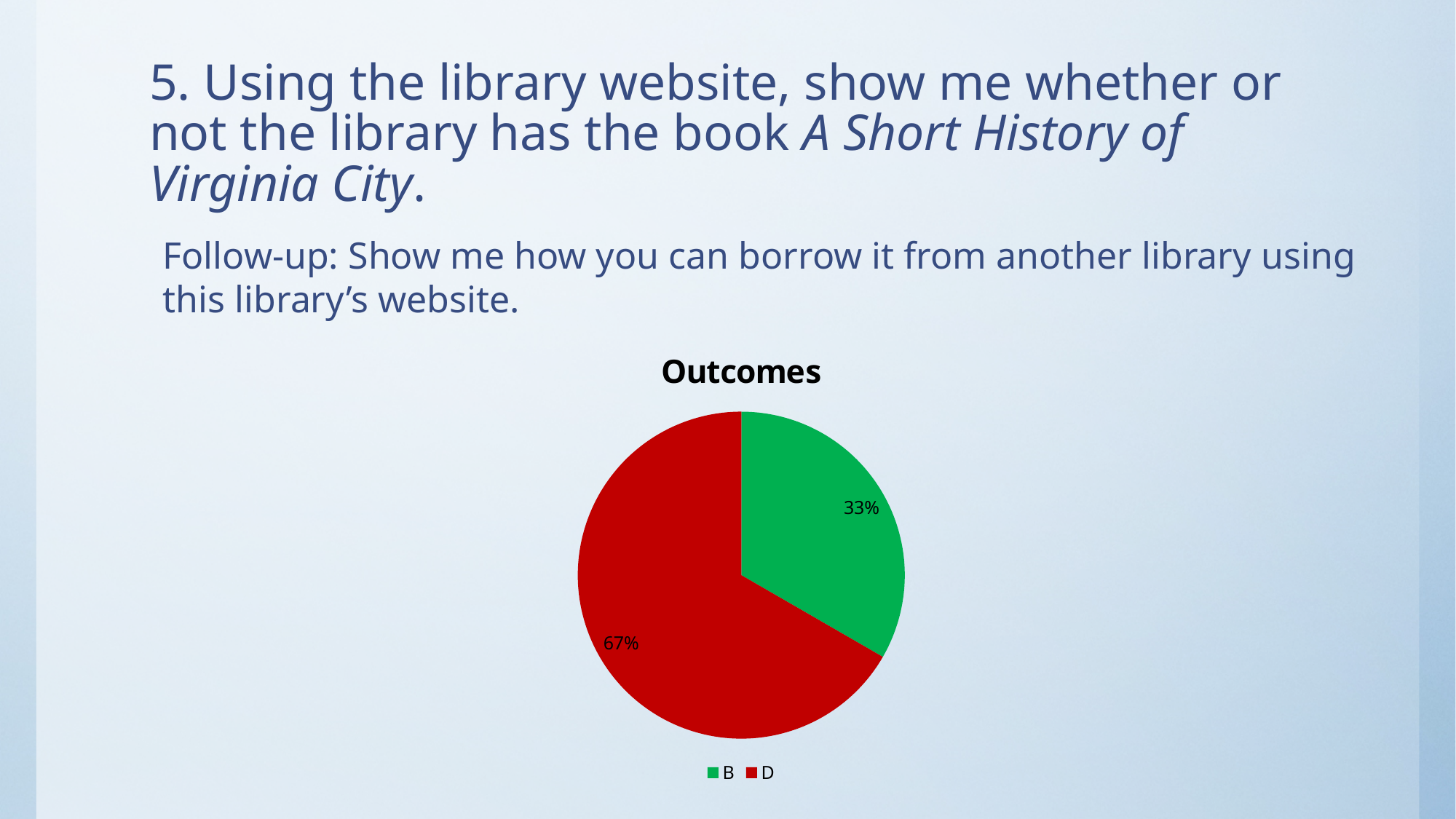
What is the difference in percentage points between the D slice and the B slice? 34 What share of the pie does category B have? 33% How many entries does the legend list? 2 What share of the pie does category D have? 67% What is the title of the chart? Outcomes What colour is the slice for category D? red Which category has the largest slice of the pie? D Which category has the smallest slice of the pie? B How many categories does the pie chart show? 2 What kind of chart is shown on the slide? pie chart Which is larger, the slice for B or the slice for D? D